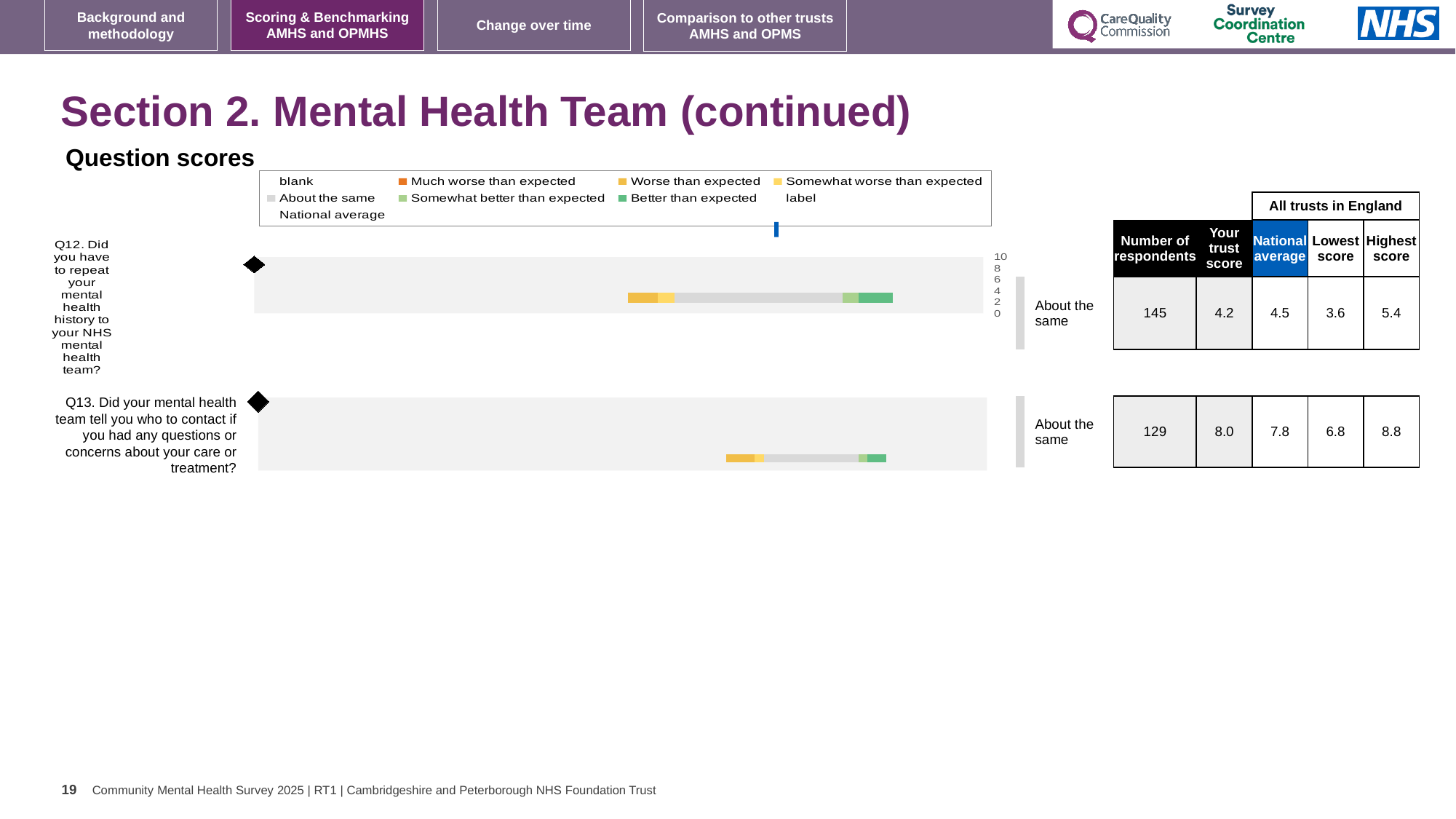
What colour does the legend use for 'Better than expected'? green How many questions (Q12 and Q13) are plotted on the slide? 2 For Q13, which is larger: the trust score or the national average? the trust score What is the difference between the highest score and the lowest score shown for Q13? 2.0 What is the difference between the national average and the trust score shown for Q12? 0.3 How many entries does the chart legend list? 9 What is the national average shown for Q13? 7.8 What benchmark category label is shown next to the Q12 bar? About the same What is the highest score across all trusts in England shown for Q13? 8.8 What kind of chart is used to show the Q12 and Q13 question scores? bar chart What is the 'Your trust score' value shown for Q12? 4.2 How many respondents are shown for Q12? 145